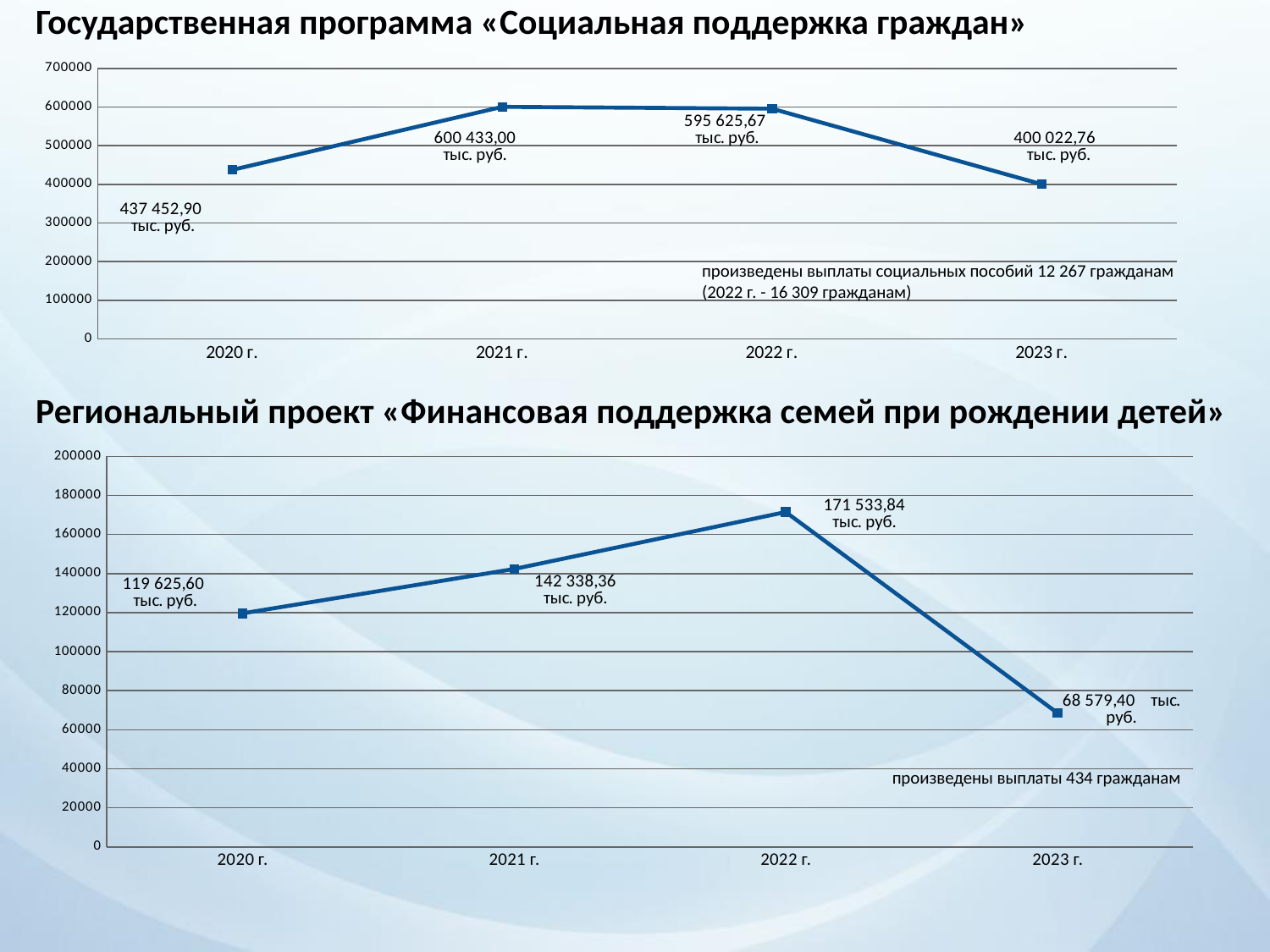
In the chart «Региональный проект «Финансовая поддержка семей при рождении детей»», what is the value for 2022 г.? 171 533,84 тыс. руб. In the chart «Государственная программа «Социальная поддержка граждан»», what is the difference between the values for 2021 г. and 2022 г.? 4 807,33 тыс. руб. In the chart «Государственная программа «Социальная поддержка граждан»», what is the value for 2021 г.? 600 433,00 тыс. руб. What type of chart is used for «Региональный проект «Финансовая поддержка семей при рождении детей»»? Line chart In the chart «Региональный проект «Финансовая поддержка семей при рождении детей»», what is the value for 2020 г.? 119 625,60 тыс. руб. In the chart «Государственная программа «Социальная поддержка граждан»», what is the value for 2023 г.? 400 022,76 тыс. руб. In the chart «Государственная программа «Социальная поддержка граждан»», how many years are plotted? 4 In the chart «Государственная программа «Социальная поддержка граждан»», which year has the highest value? 2021 г. In the chart «Региональный проект «Финансовая поддержка семей при рождении детей»», which year has the lowest value? 2023 г. In the chart «Региональный проект «Финансовая поддержка семей при рождении детей»», what is the difference between the values for 2022 г. and 2021 г.? 29 195,48 тыс. руб. In the chart «Государственная программа «Социальная поддержка граждан»», which year has the lowest value? 2023 г. In the chart «Региональный проект «Финансовая поддержка семей при рождении детей»», is the value for 2021 г. greater or less than 140000? greater